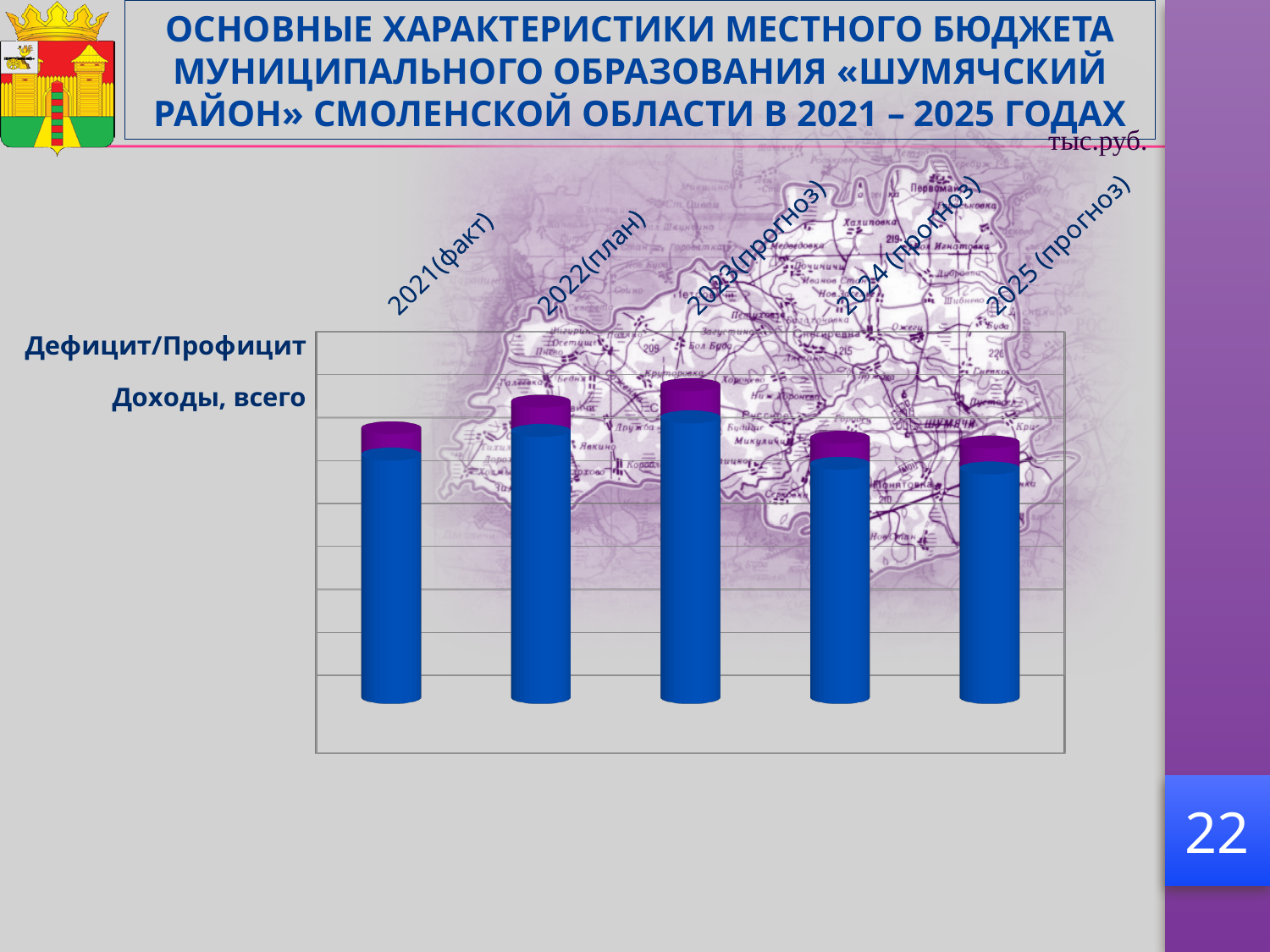
Do the Доходы, всего bars rise or fall from 2023(прогноз) to 2025 (прогноз)? Fall Which year has the highest bar for Доходы, всего? 2023(прогноз) What kind of chart is shown on the slide? Bar chart What unit of measurement is indicated for the chart? тыс.руб. Which is larger, the Доходы, всего bar for 2023(прогноз) or for 2021(факт)? 2023(прогноз) Which is larger, the Доходы, всего bar for 2022(план) or for 2024 (прогноз)? 2022(план) Do the Доходы, всего bars rise or fall from 2021(факт) to 2023(прогноз)? Rise How many categories (years) are shown on the x axis of the chart? 5